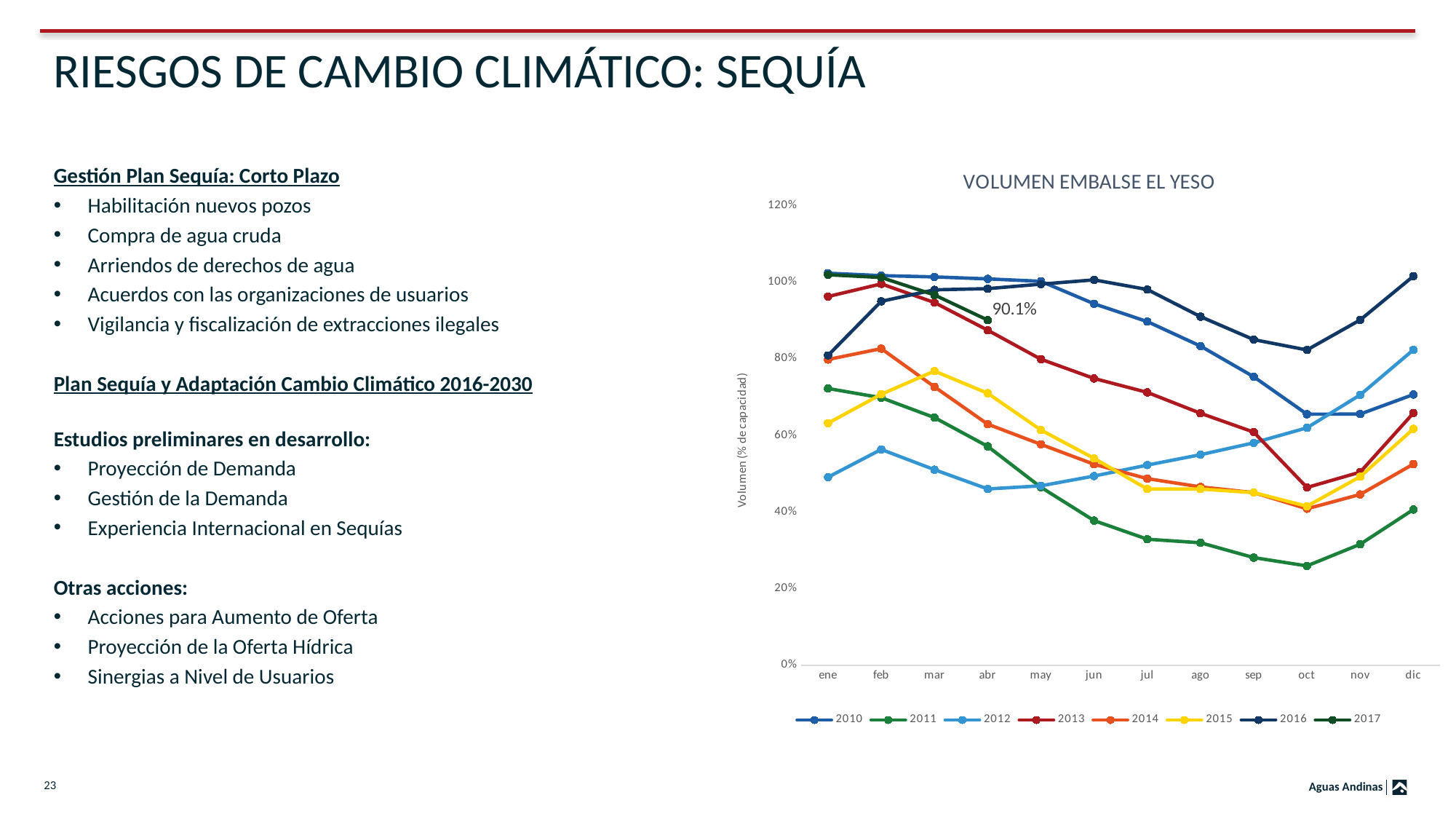
What value is labelled for the 2017 series in abr? 90.1% Which series has the lowest value in oct? 2011 Which is larger in dic, the value for 2012 or the value for 2011? 2012 Is the value for 2011 in oct greater or less than 40%? less How many series does the chart legend list? 8 Does the 2011 series rise or fall from ene to oct? fall Is the value for 2016 in dic greater or less than 80%? greater What is the label of the vertical axis? Volumen (% de capacidad) Which series has the highest value in dic? 2016 How many months are shown along the x axis of the chart? 12 What is the title of the chart? VOLUMEN EMBALSE EL YESO What kind of chart is shown on the slide? line chart